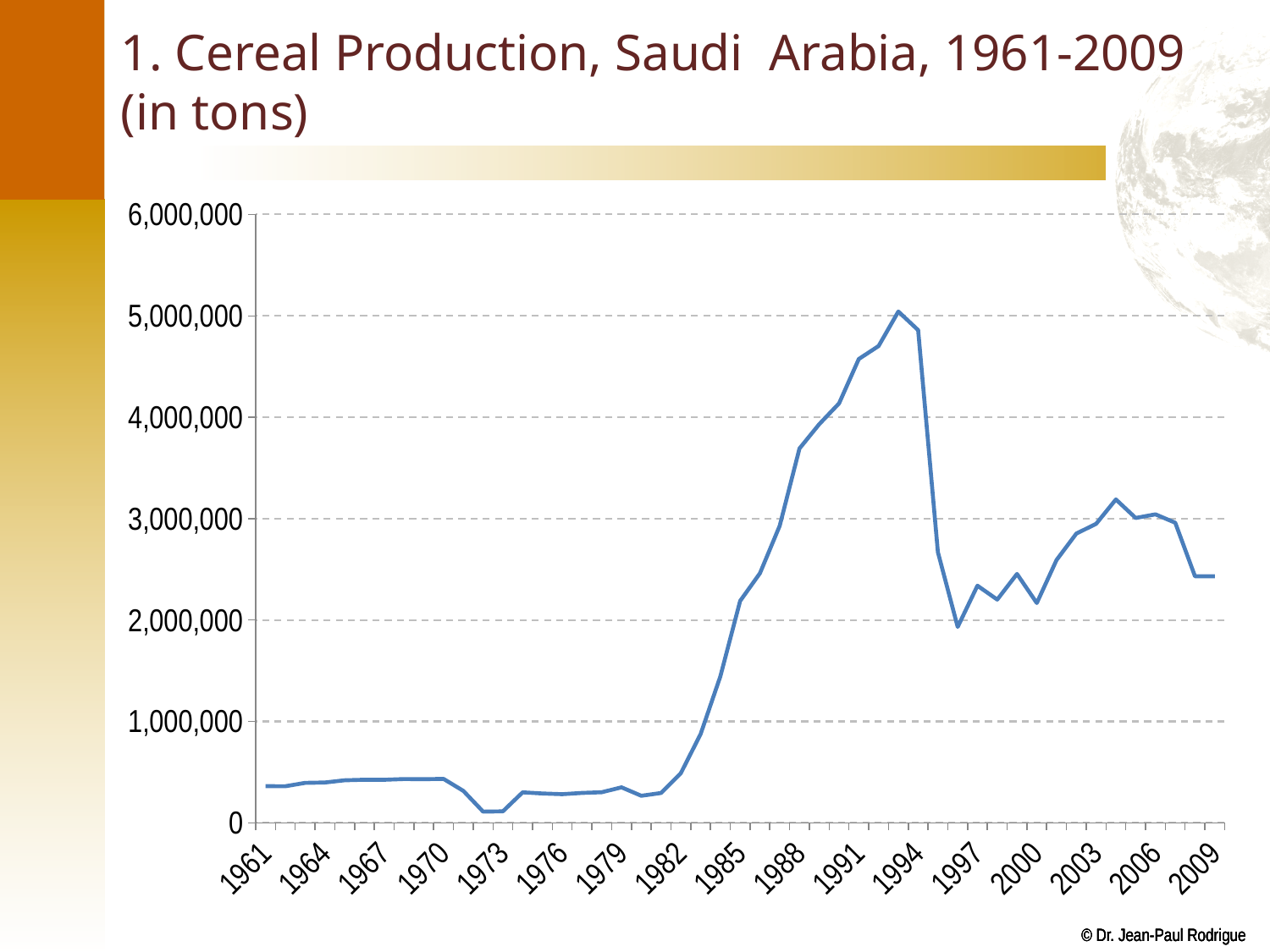
What is the highest value labeled on the vertical axis? 6,000,000 Is the value for 1982 greater or less than 1,000,000? less Does cereal production rise or fall between 1982 and 1991? rise Which year has the larger value, 1970 or 1973? 1970 Is the value for 1988 greater or less than 3,000,000? greater Which year has the larger value, 1991 or 2009? 1991 Is the value for 2009 greater or less than 3,000,000? less What is the title of the chart? 1. Cereal Production, Saudi Arabia, 1961-2009 (in tons) What kind of chart is shown on the slide? line chart Does cereal production rise or fall between 1994 and 1997? fall